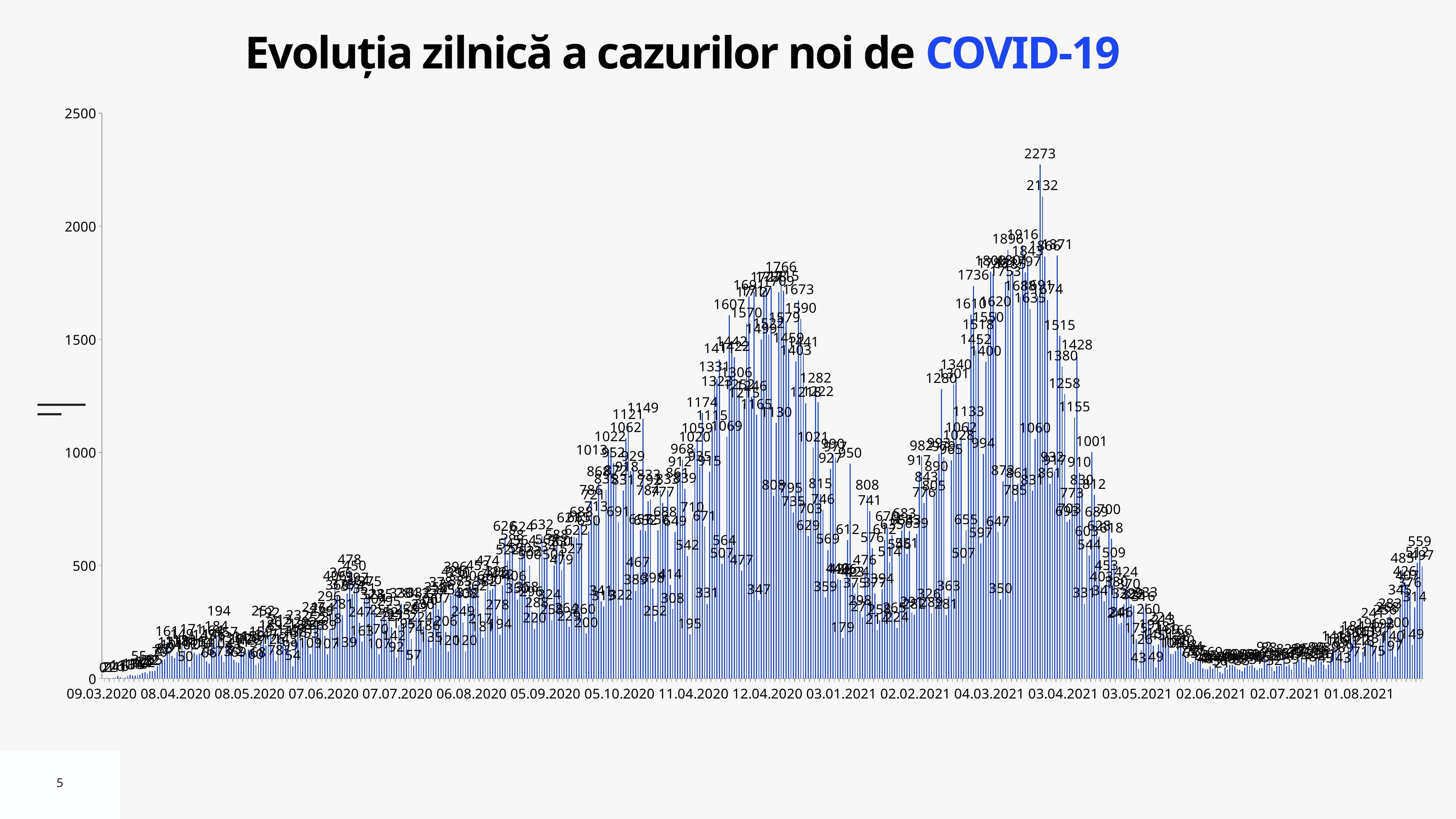
Is the peak value of the wave around 12.04.2020 (1766) greater or less than 2000? less What is the title of the chart? Evoluția zilnică a cazurilor noi de COVID-19 What kind of chart is shown on the slide? bar chart Do the values rise or fall from 02.06.2021 to the right end of the chart? rise What is the highest value printed in the rising section after 01.08.2021? 559 What is the second-highest daily value printed on the chart, just below the 2273 peak? 2132 What is the highest daily value printed on the chart? 2273 Are the values around 02.06.2021 greater or less than 500? less What is the highest value shown on the y axis? 2500 Is the highest bar on the chart greater or less than 2000? greater Which period has the taller peak: around 12.04.2020 or around 03.04.2021? around 03.04.2021 What is the first date label on the x axis? 09.03.2020